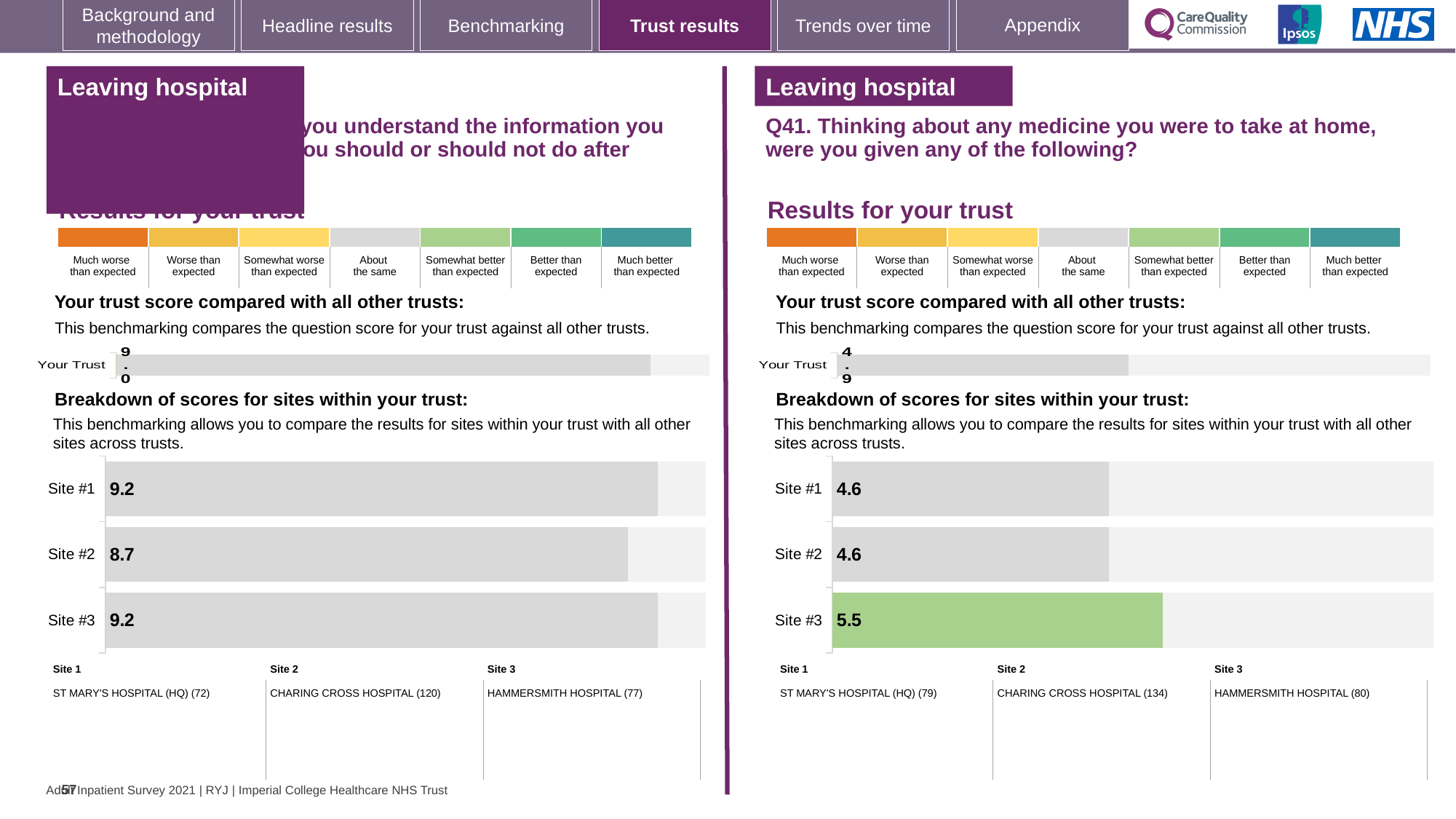
In the left-hand 'Breakdown of scores for sites within your trust' chart, what is the difference between the scores for Site #1 and Site #2? 0.5 In the right-hand (Q41) 'Breakdown of scores for sites within your trust' chart, what is the difference between the scores for Site #3 and Site #1? 0.9 In the left-hand 'Your Trust' chart, what is the trust score shown? 9.0 In the right-hand (Q41) 'Breakdown of scores for sites within your trust' chart, is the score for Site #1 larger or smaller than the score for Site #3? smaller In the left-hand 'Breakdown of scores for sites within your trust' chart, what is the score for Site #2? 8.7 In the left-hand 'Breakdown of scores for sites within your trust' chart, which site has the lowest score? Site #2 In the left-hand 'Breakdown of scores for sites within your trust' chart, what is the score for Site #1? 9.2 In the right-hand (Q41) 'Breakdown of scores for sites within your trust' chart, which site has the highest score? Site #3 What type of chart is the left-hand 'Breakdown of scores for sites within your trust' chart? bar chart In the right-hand (Q41) 'Your Trust' chart, what is the trust score shown? 4.9 In the right-hand (Q41) 'Breakdown of scores for sites within your trust' chart, what is the score for Site #3? 5.5 How many sites are shown in the right-hand (Q41) 'Breakdown of scores for sites within your trust' chart? 3